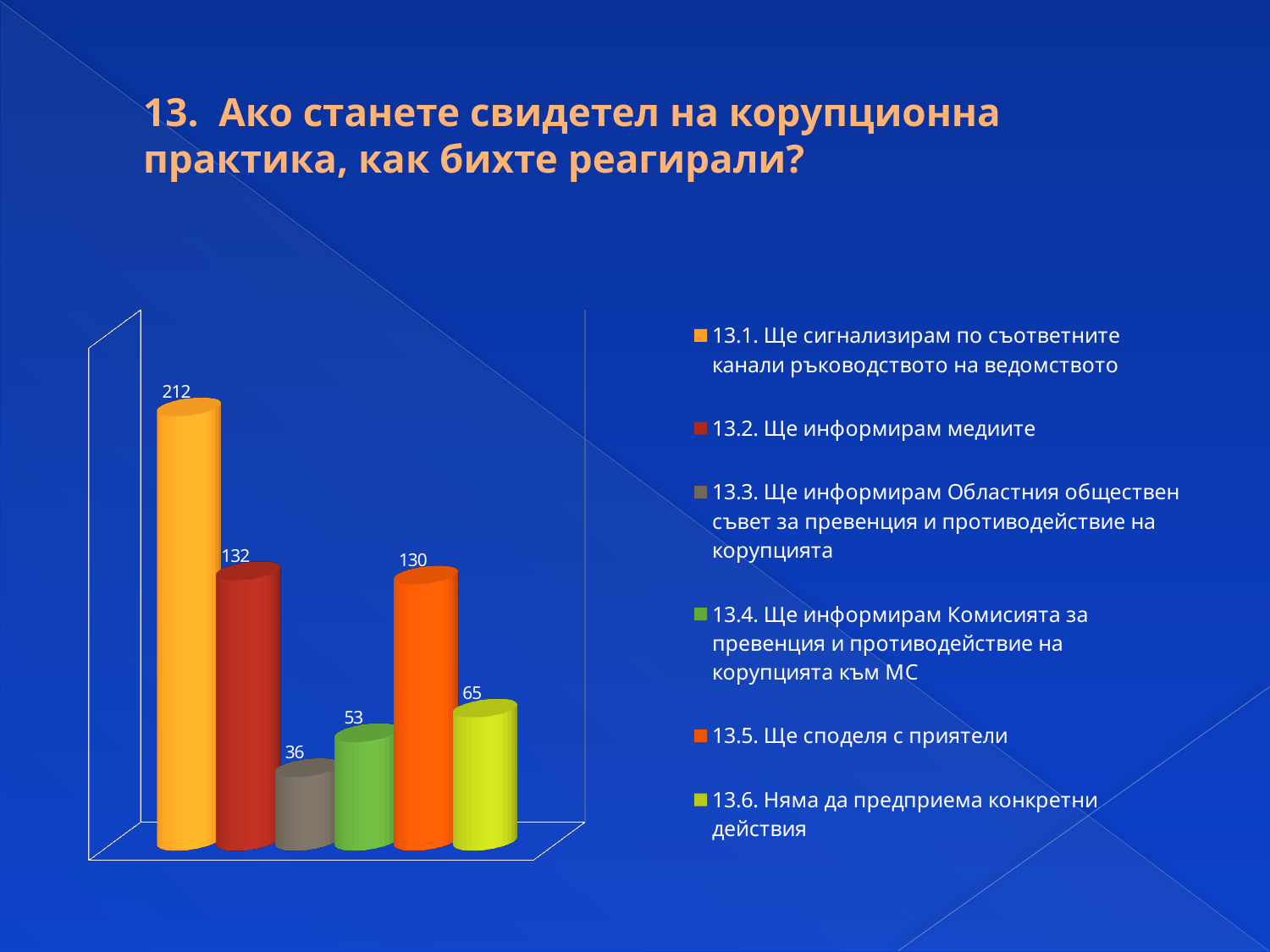
Which response option has the lowest value? 13.3. Ще информирам Областния обществен съвет за превенция и противодействие на корупцията Which is larger: the value for "13.4. Ще информирам Комисията за превенция и противодействие на корупцията към МС" or the value for "13.6. Няма да предприема конкретни действия"? 13.6. Няма да предприема конкретни действия How many bars are plotted in the chart? 6 What is the value for "13.2. Ще информирам медиите"? 132 What is the value for "13.6. Няма да предприема конкретни действия"? 65 What is the difference between the values for "13.1. Ще сигнализирам по съответните канали ръководството на ведомството" and "13.2. Ще информирам медиите"? 80 What kind of chart is shown on the slide? Bar chart Which response option has the highest value? 13.1. Ще сигнализирам по съответните канали ръководството на ведомството What is the value for "13.1. Ще сигнализирам по съответните канали ръководството на ведомството"? 212 How many entries does the legend list? 6 What is the value for "13.5. Ще споделя с приятели"? 130 What is the difference between the values for "13.6. Няма да предприема конкретни действия" and "13.3. Ще информирам Областния обществен съвет за превенция и противодействие на корупцията"? 29